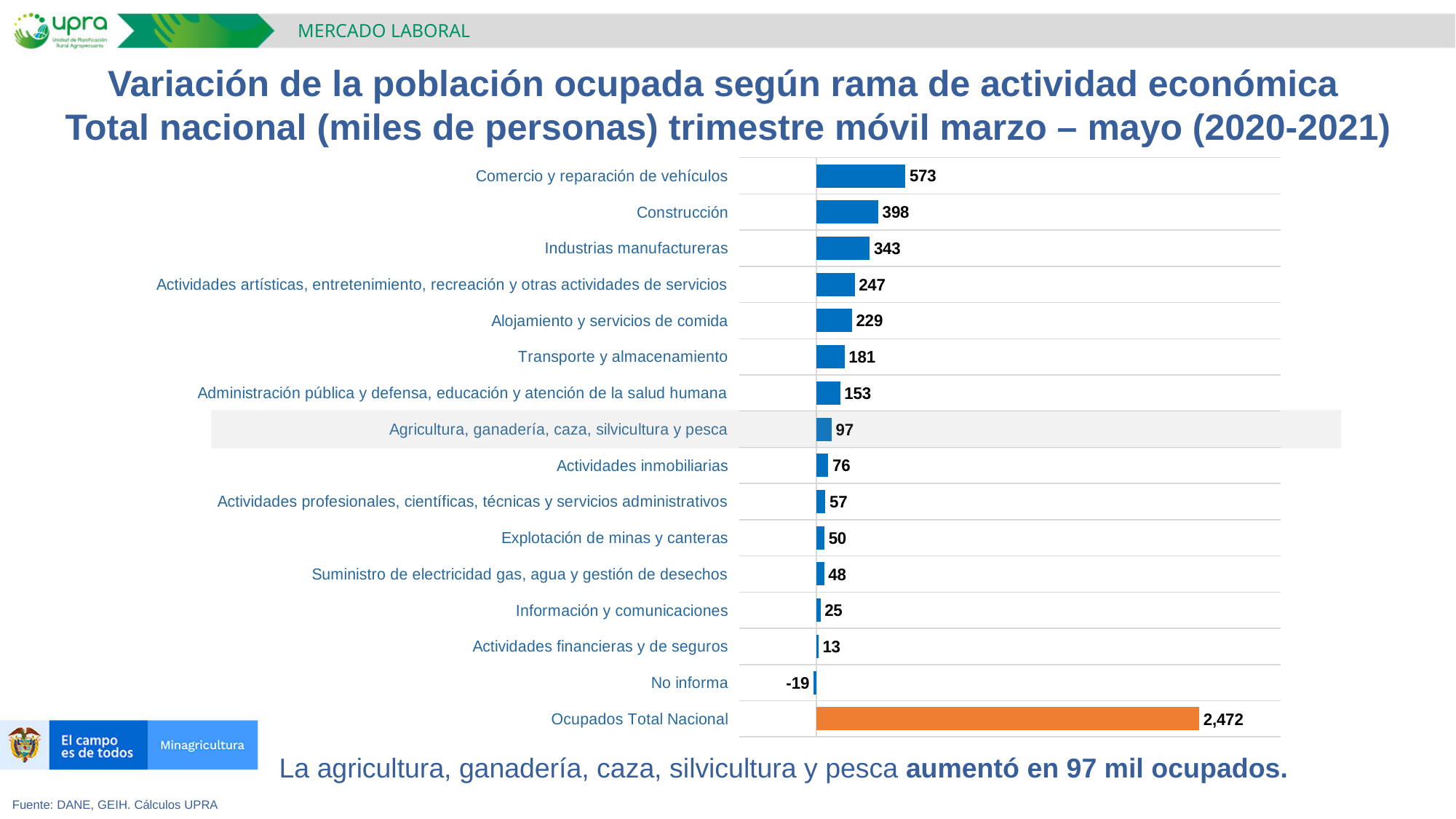
How many categories are shown in the chart? 16 What is the difference between the values for Actividades inmobiliarias and Información y comunicaciones? 51 What is the value for Comercio y reparación de vehículos? 573 What is the difference between the values for Construcción and Industrias manufactureras? 55 What is the value for No informa? -19 What is the value for Ocupados Total Nacional? 2,472 Which category has the lowest value? No informa Which bar is shown in orange rather than blue? Ocupados Total Nacional Which economic activity (excluding the national total) has the highest value? Comercio y reparación de vehículos What kind of chart is shown on the slide? Bar chart Which is larger, the value for Transporte y almacenamiento or the value for Alojamiento y servicios de comida? Alojamiento y servicios de comida What is the value for Agricultura, ganadería, caza, silvicultura y pesca? 97